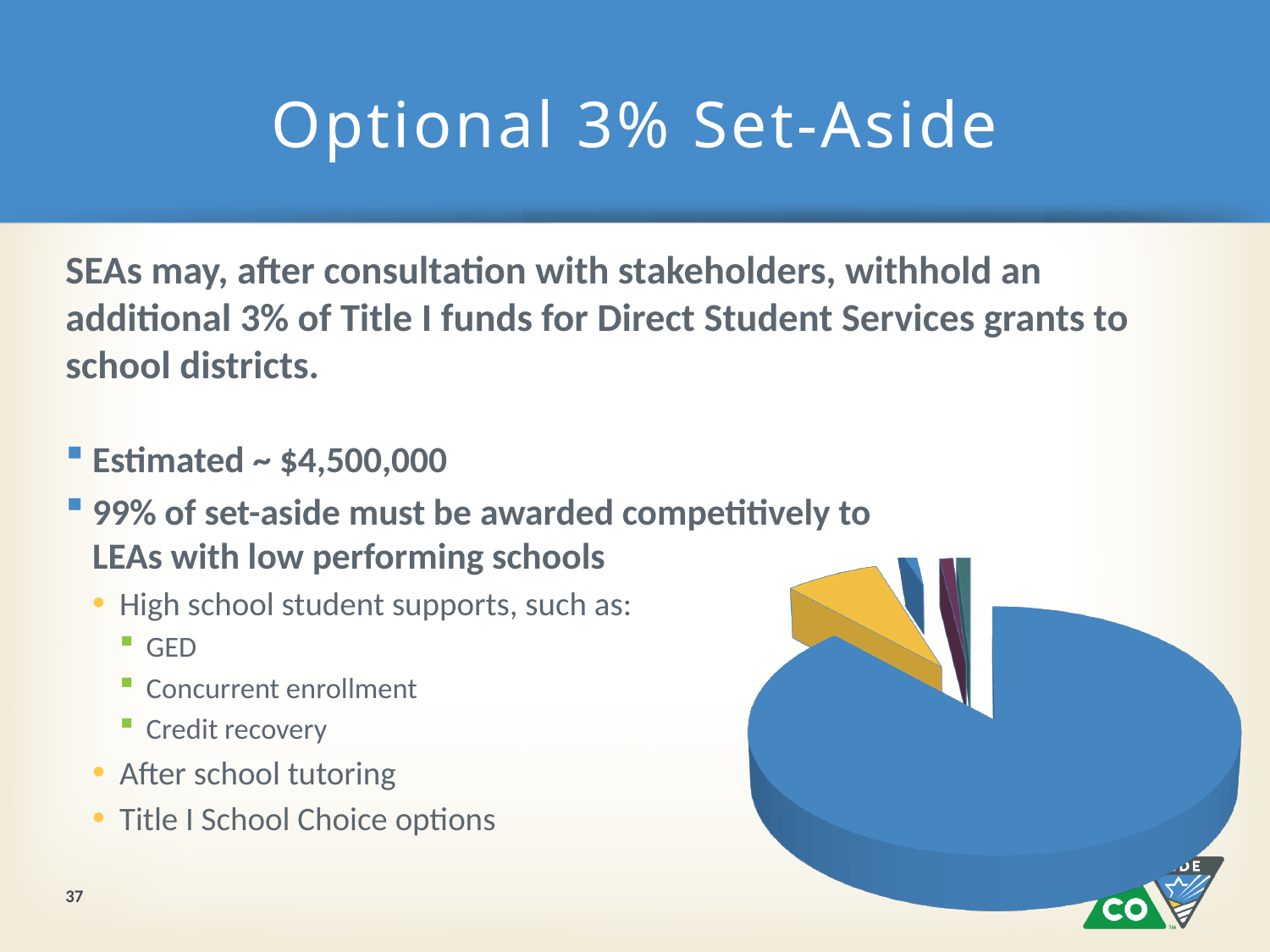
What colour is the largest slice of the pie chart? blue What kind of chart is shown on the slide? pie chart Does the pie chart display a legend? No Which slice is larger in the pie chart, the blue slice or the yellow slice? blue What colour is the second-largest slice of the pie chart? yellow